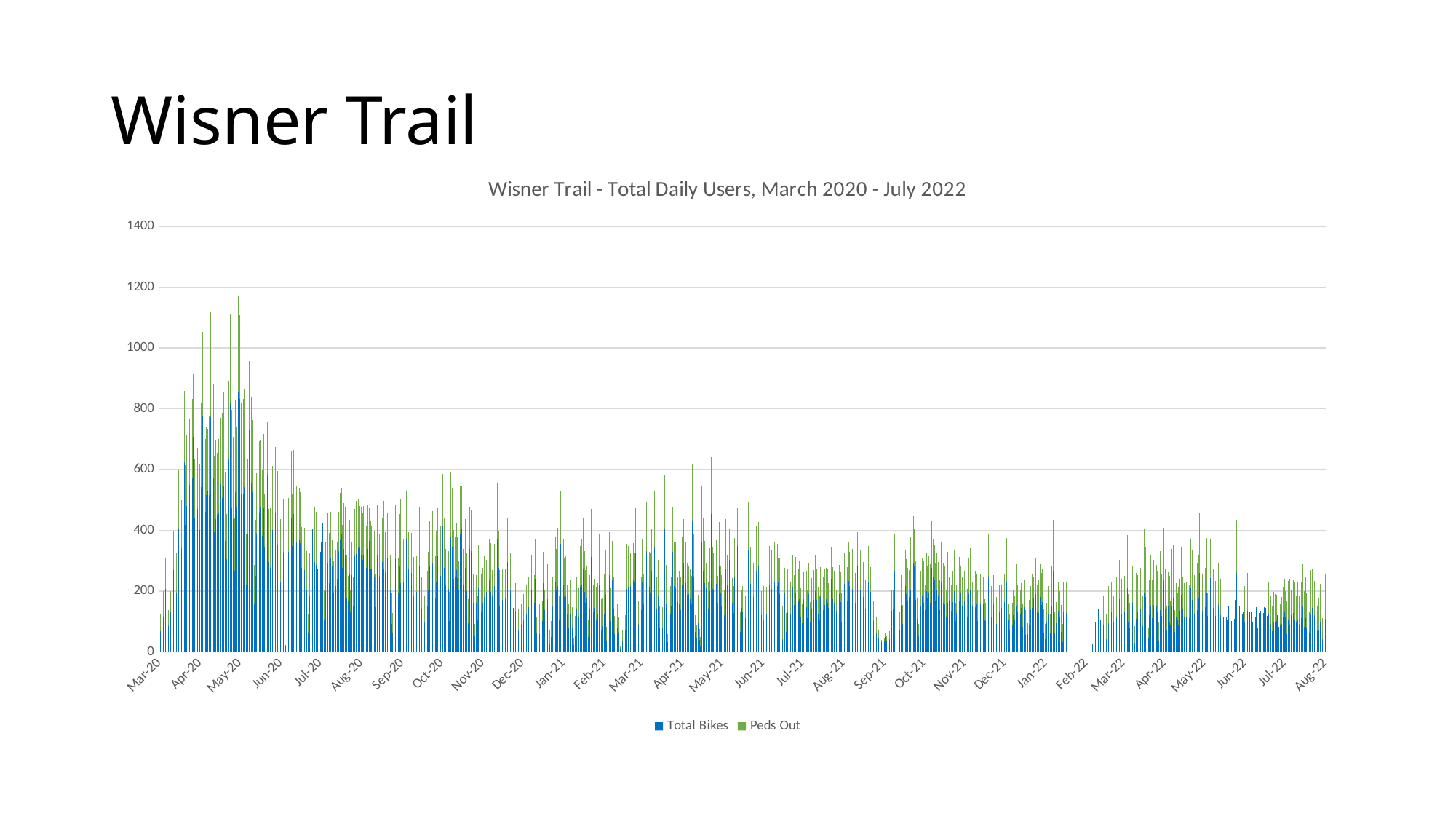
Is the tallest bar on the chart greater or less than 1200? less In which period do the tallest bars occur? Around Apr-20 to May-20 Are the bars around Jul-22 greater or less than 400? less How many month labels are shown along the horizontal axis? 30 Is the tallest bar on the chart greater or less than 1000? greater How many series does the legend list? 2 Overall, do the daily user totals rise or fall from spring 2020 to summer 2022? Fall What are the two series named in the legend? Total Bikes and Peds Out What kind of chart is shown on the slide? Bar chart Which month label has a gap with no bars plotted? Feb-22 What is the highest value shown on the vertical axis? 1400 What is the title of the chart? Wisner Trail - Total Daily Users, March 2020 - July 2022